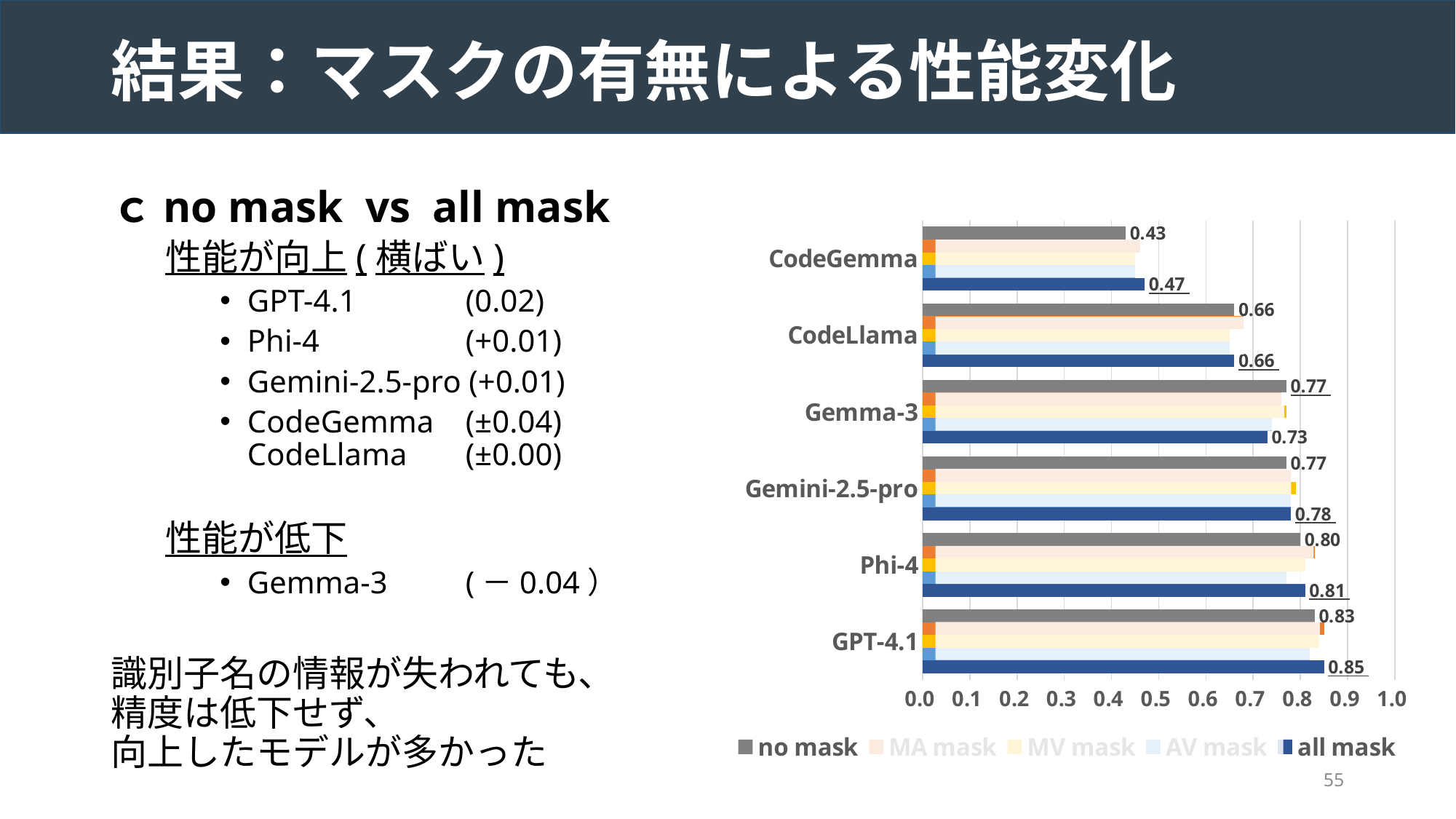
For Gemma-3, which is larger: the "no mask" value or the "all mask" value? no mask How many models are shown on the chart? 6 Which model has the highest "all mask" value? GPT-4.1 What is the "no mask" value for Phi-4? 0.80 Which model has the lowest "no mask" value? CodeGemma What kind of chart is shown on the slide? Bar chart What is the difference between the "all mask" and "no mask" values for CodeGemma? 0.04 Is the "all mask" value for CodeLlama greater or less than 0.5? greater What is the "all mask" value for Gemma-3? 0.73 What is the "all mask" value for GPT-4.1? 0.85 What is the "no mask" value for CodeGemma? 0.43 How many series does the legend list? 5